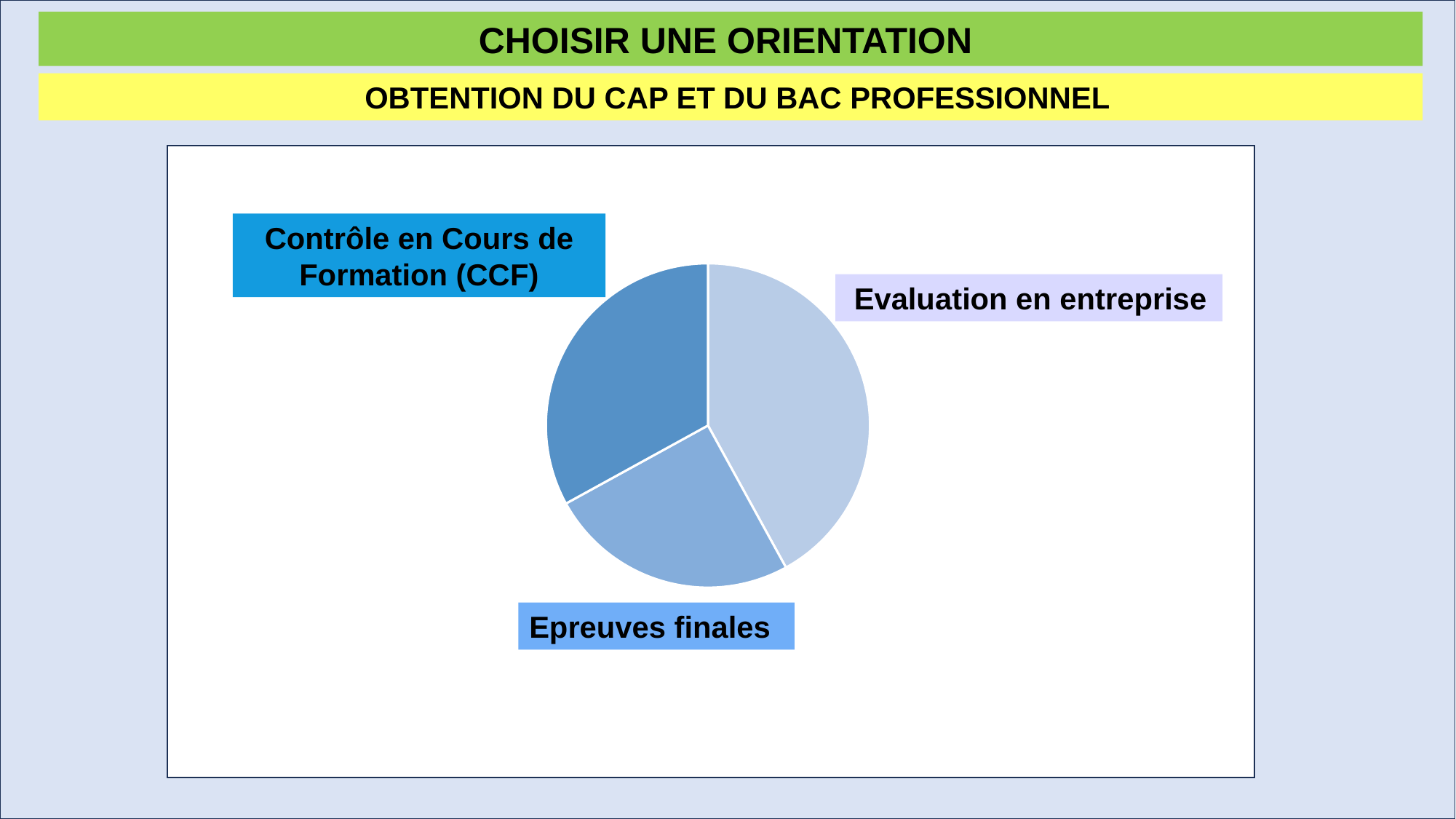
Which slice is larger: Contrôle en Cours de Formation (CCF) or Epreuves finales? Contrôle en Cours de Formation (CCF) What is the label of the darkest blue slice of the pie chart? Contrôle en Cours de Formation (CCF) Which slice is larger: Evaluation en entreprise or Epreuves finales? Evaluation en entreprise Which slice of the pie chart is the largest? Evaluation en entreprise Which slice of the pie chart is labelled at the bottom of the chart? Epreuves finales How many slices does the pie chart have? 3 Which slice of the pie chart is the smallest? Epreuves finales What kind of chart is shown on the slide? pie chart